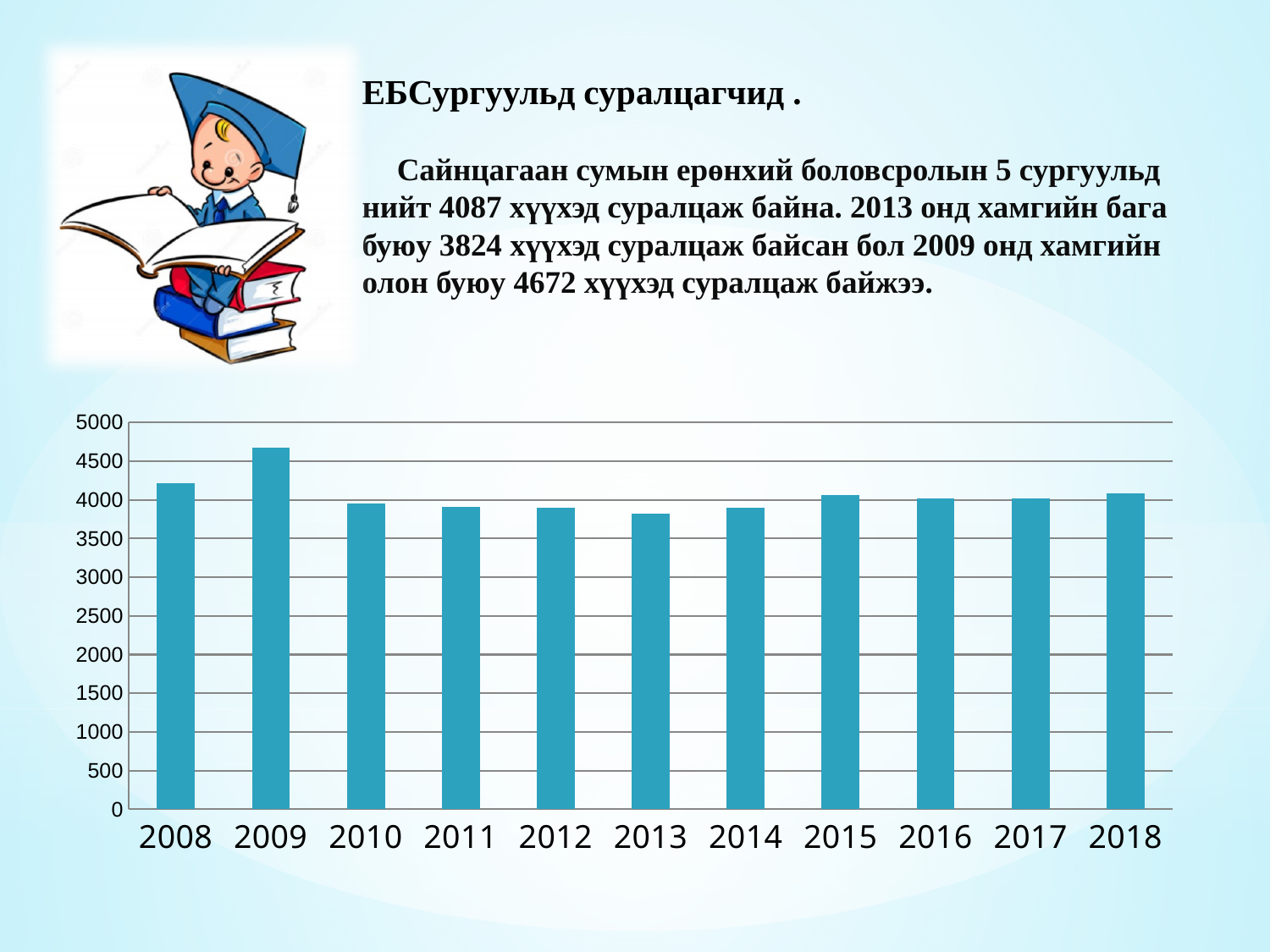
Which year has the highest bar in the chart? 2009 How many years are shown on the x axis of the chart? 11 Which year has the lowest bar in the chart? 2013 Is the value for 2008 greater or less than 4000? greater Is the value for 2009 greater or less than 4500? greater What is the first year shown on the x axis of the chart? 2008 Is the value for 2013 greater or less than 4000? less What kind of chart is shown on the slide? bar chart Do the values rise or fall from 2009 to 2013? fall Which is larger, the value for 2013 or the value for 2015? 2015 Which is larger, the value for 2008 or the value for 2010? 2008